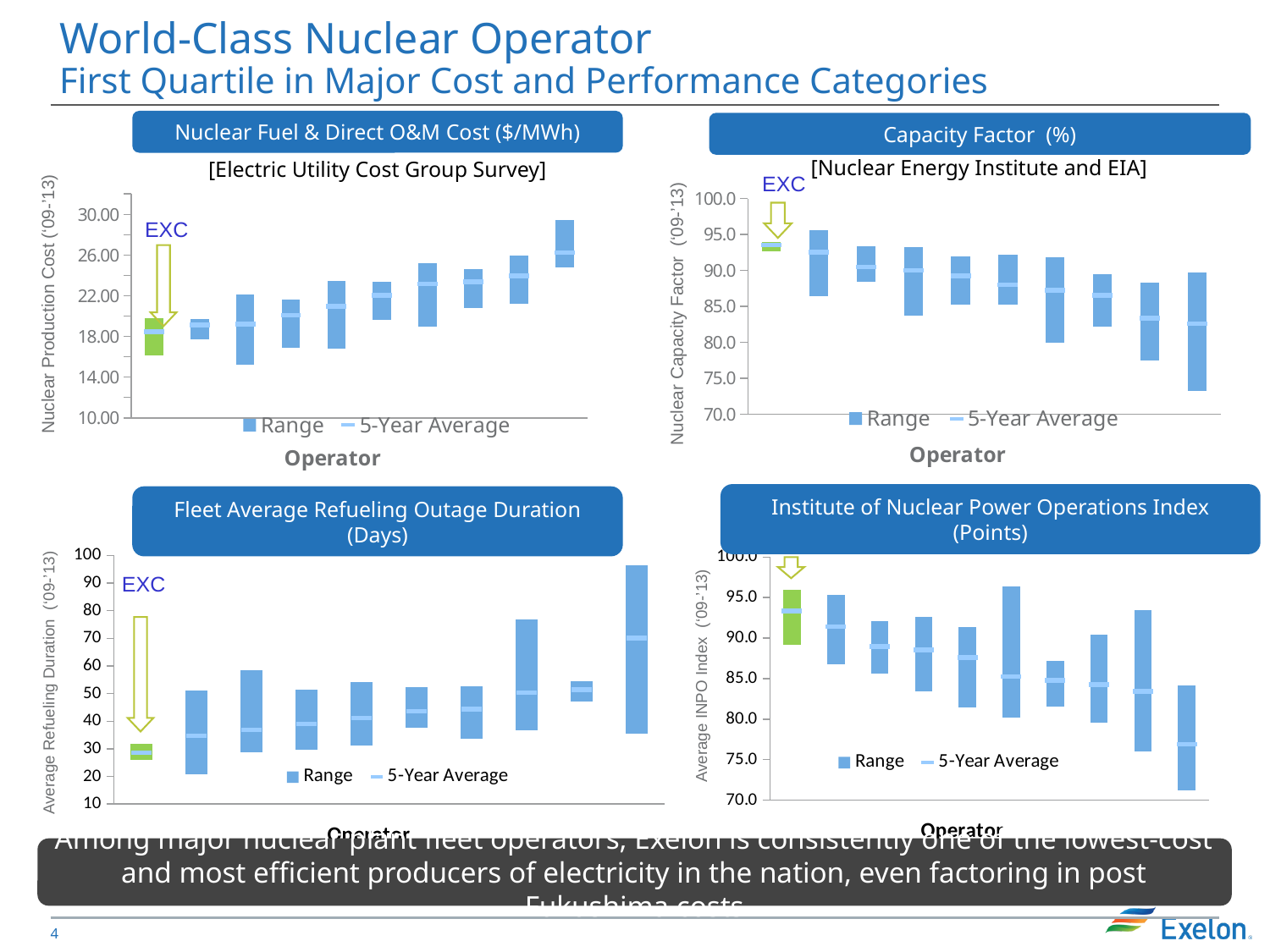
In the Capacity Factor (%) chart, how many series does the legend list? 2 In the Nuclear Fuel & Direct O&M Cost chart, what kind of chart is shown? Bar chart In the Fleet Average Refueling Outage Duration (Days) chart, which operator has the lowest 5-year average? EXC In the Institute of Nuclear Power Operations Index (Points) chart, is the 5-year average for EXC greater or less than 90.0? greater In the Fleet Average Refueling Outage Duration (Days) chart, is the 5-year average for EXC greater or less than 40? less In the Fleet Average Refueling Outage Duration (Days) chart, how many operators are plotted? 10 In the Nuclear Fuel & Direct O&M Cost chart, do the operators' values generally rise or fall from left to right along the x axis? rise In the Capacity Factor (%) chart, is the 5-year average for EXC greater or less than 90.0? greater In the Institute of Nuclear Power Operations Index (Points) chart, how many operators are plotted? 10 In the Nuclear Fuel & Direct O&M Cost chart, what are the two legend entries? Range and 5-Year Average In the Capacity Factor (%) chart, do the operators' values generally rise or fall from left to right along the x axis? fall